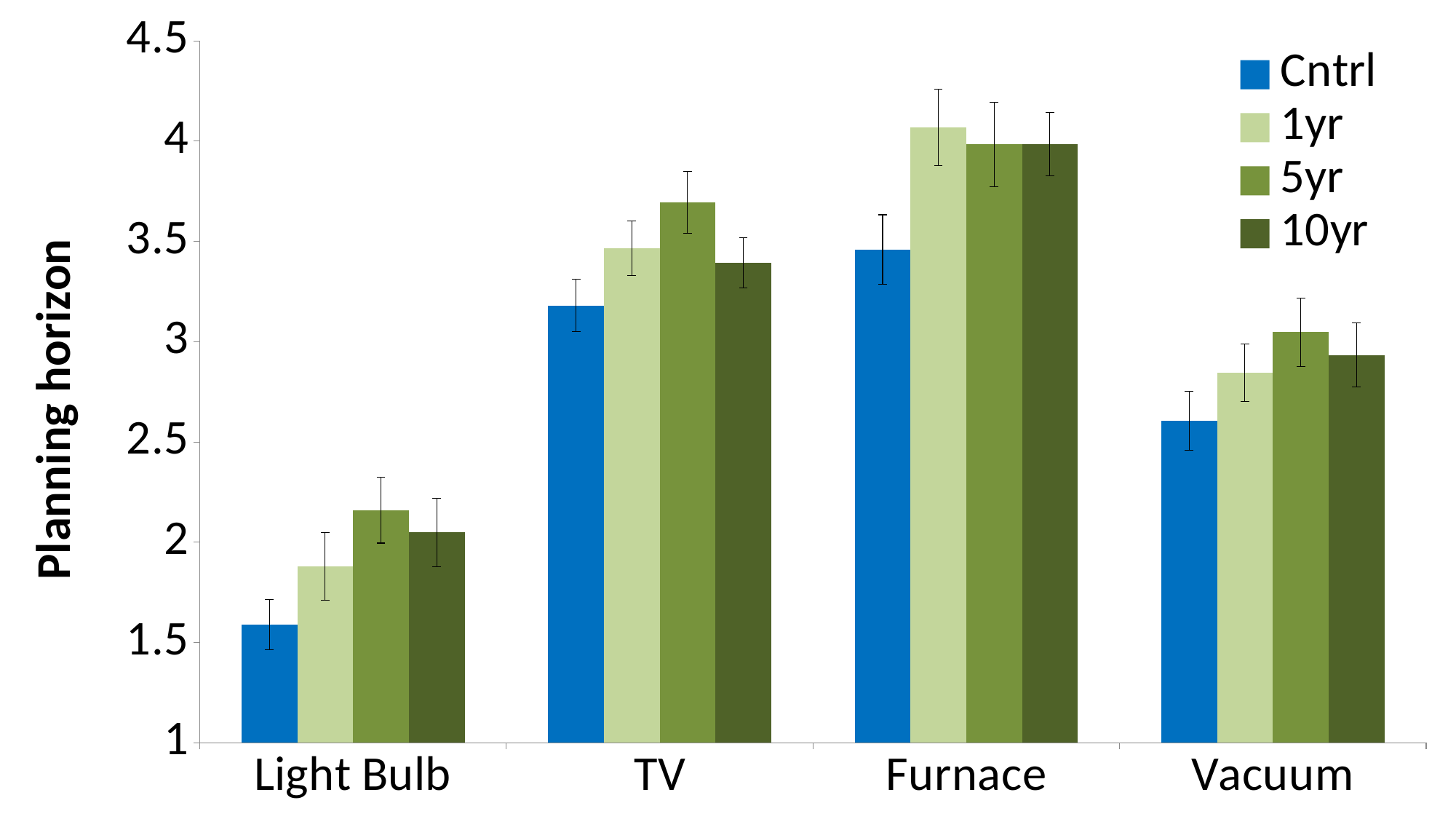
Is the Cntrl value for Light Bulb greater or less than 2? less Which product has the highest Cntrl bar? Furnace What is the label on the y axis? Planning horizon Is the 5yr value for TV greater or less than 3.5? greater Is the Cntrl value for TV greater or less than 3? greater What kind of chart is shown on the slide? bar chart For TV, which is larger: the 5yr bar or the 10yr bar? 5yr How many product categories are shown on the x axis? 4 Which series has the highest bar for TV? 5yr For Furnace, which is larger: the Cntrl bar or the 1yr bar? 1yr Which product has the lowest Cntrl bar? Light Bulb How many series does the legend list? 4